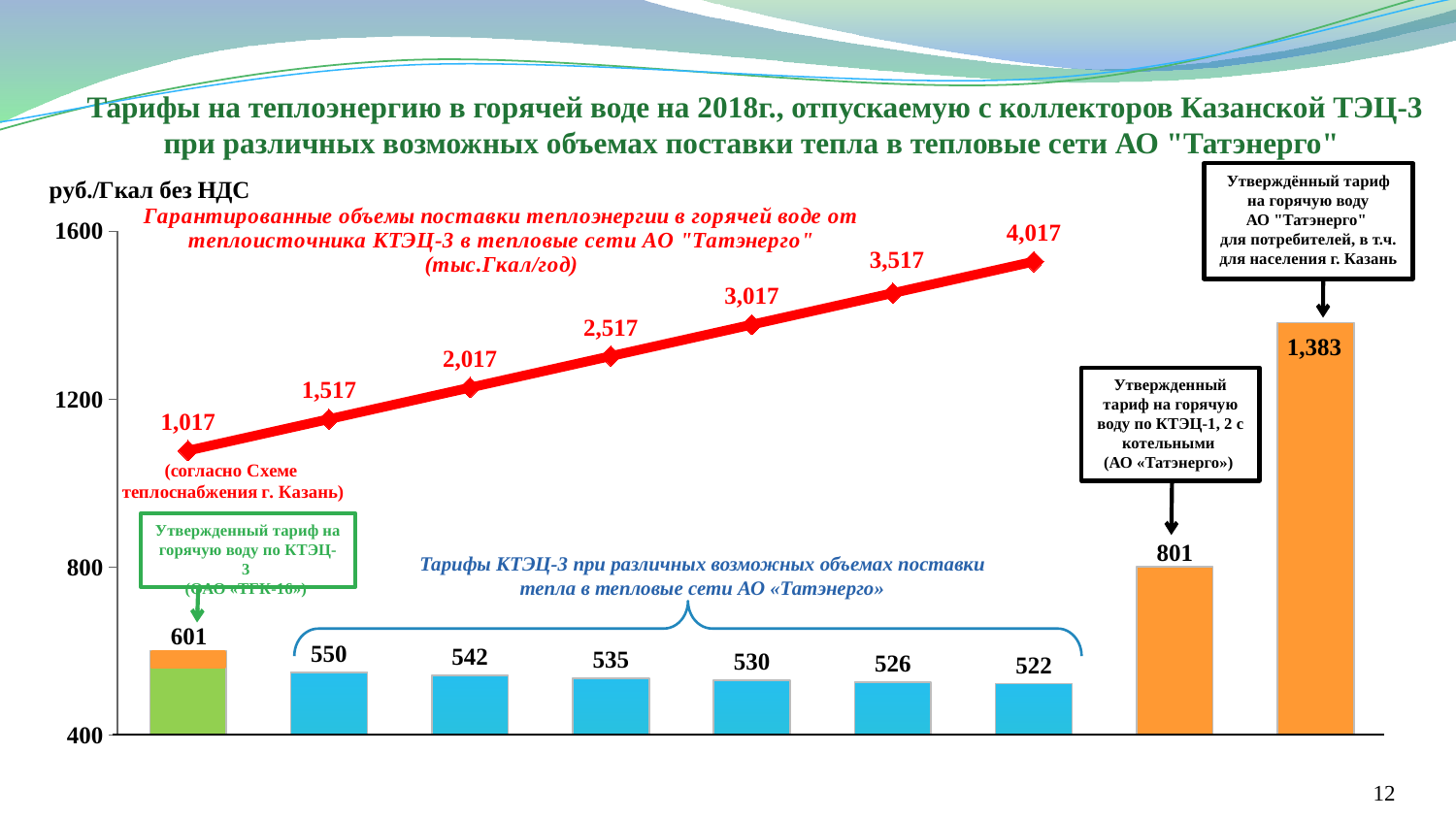
How many data points are labelled on the red line of guaranteed supply volumes? 7 Among the blue bars showing KTEC-3 tariffs at various possible supply volumes, which is the lowest value? 522 What is the approved tariff for hot water from KTEC-1, 2 with boilers (AO «Tatenergo»), as labelled on the orange bar? 801 What is the difference between the highest and lowest blue-bar tariffs for KTEC-3 (550 and 522)? 28 What is the difference between the approved AO "Tatenergo" tariff for consumers (1,383) and the approved tariff for KTEC-1, 2 with boilers (801)? 582 Do the values on the red line of guaranteed heat supply volumes rise or fall from left to right? rise What is the approved tariff for hot water of AO "Tatenergo" for consumers, including the population of Kazan, shown on the tallest orange bar? 1,383 What unit is shown for the vertical axis of the chart? руб./Гкал без НДС Among the blue bars showing KTEC-3 tariffs at various possible supply volumes, which is the highest value? 550 What is the highest value labelled on the red line of guaranteed supply volumes? 4,017 Which is larger: the approved tariff for KTEC-1, 2 with boilers or the approved tariff for KTEC-3 (OAO «TGK-16»)? KTEC-1, 2 with boilers (801) What is the approved tariff for hot water from KTEC-3 (OAO «TGK-16»), labelled on the first bar? 601